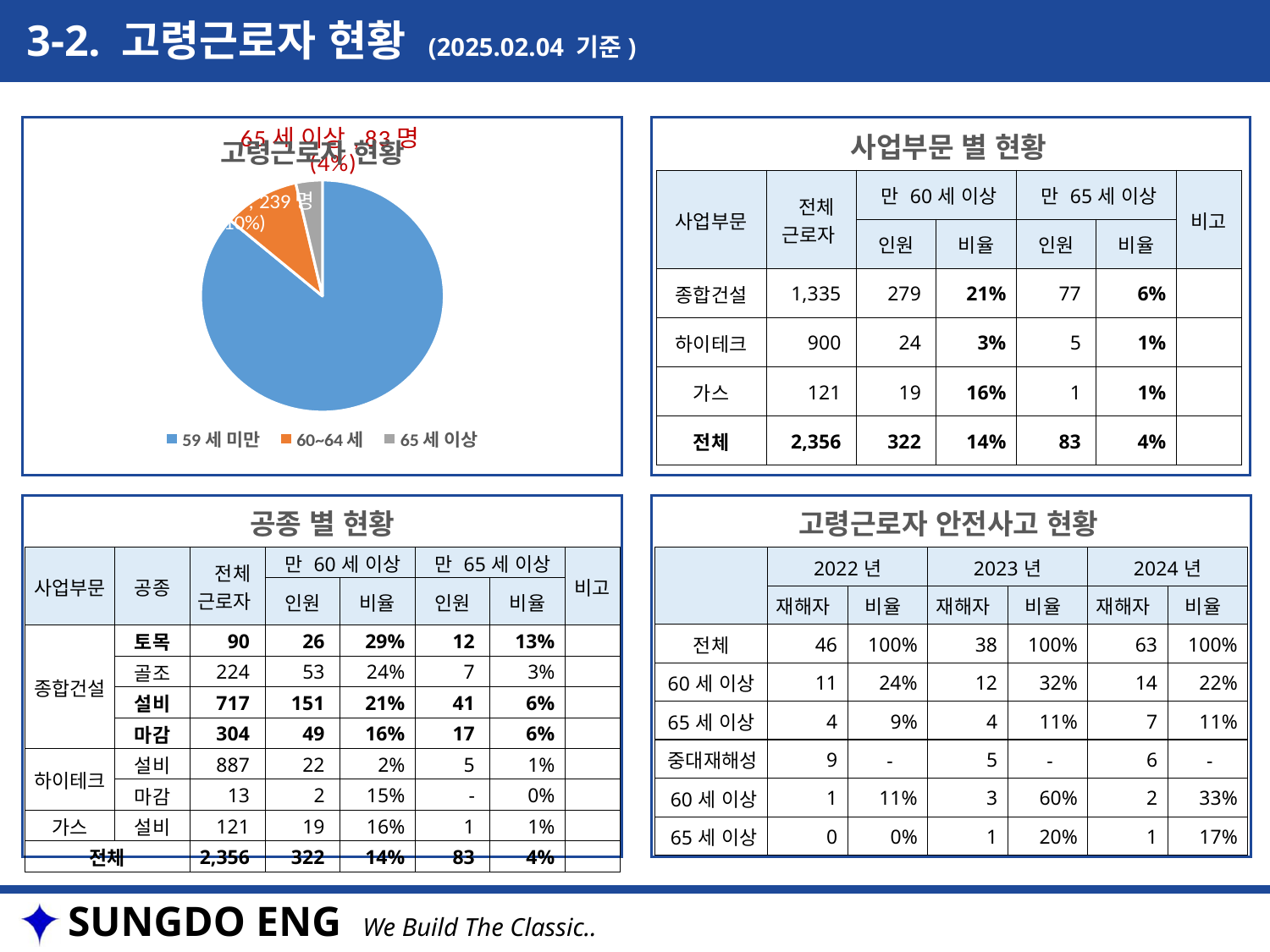
According to the data label on the orange slice, how many workers are in the 60~64 세 category? 239 명 Which category has the largest slice in the pie chart? 59 세 미만 What kind of chart is shown on the slide? pie chart How many categories does the pie chart's legend list? 3 Which slice is larger, 60~64 세 or 65 세 이상? 60~64 세 According to the data label, how many workers are in the 65 세 이상 category? 83 명 What colour represents the 59 세 미만 category in the pie chart? blue What share of the pie does the 65 세 이상 slice represent, according to its data label? 4% Which category has the smallest slice in the pie chart? 65 세 이상 What is the title of the pie chart? 고령근로자 현황 What is the difference between the 60~64 세 value (239 명) and the 65 세 이상 value (83 명)? 156 명